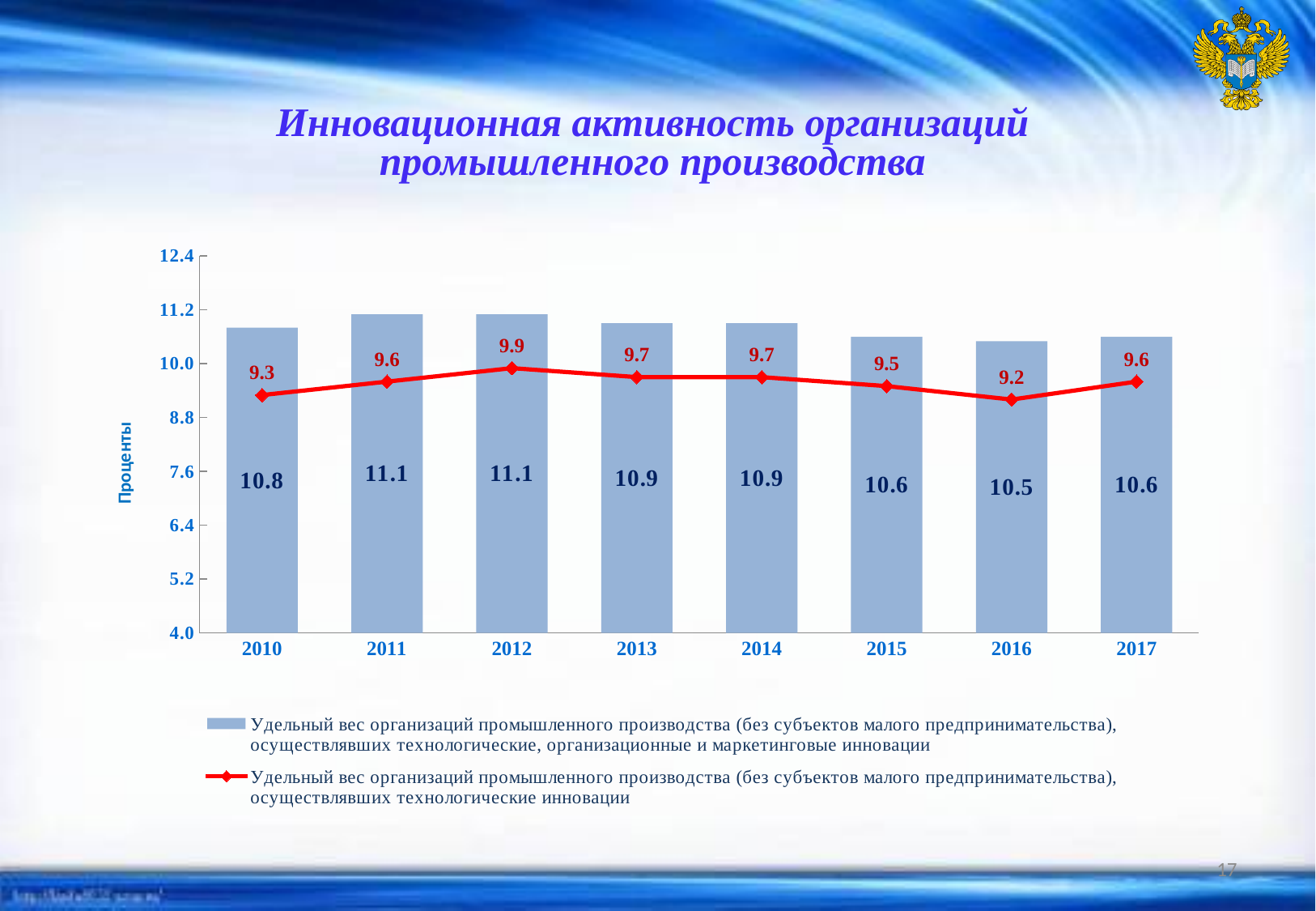
What is the difference between the bar value and the line value for 2017? 1.0 What is the value of the bar series for 2010? 10.8 How many series does the legend list? 2 What is the label on the vertical axis of the chart? Проценты How many years are shown on the x axis? 8 What is the value of the bar series for 2016? 10.5 What is the value of the red line series for 2012? 9.9 What kind of chart is shown on the slide? Combined bar and line chart Which year has the larger bar value, 2011 or 2015? 2011 In which year does the red line series reach its highest value? 2012 In which year is the bar series at its lowest value? 2016 In which year is the red line series at its lowest value? 2016